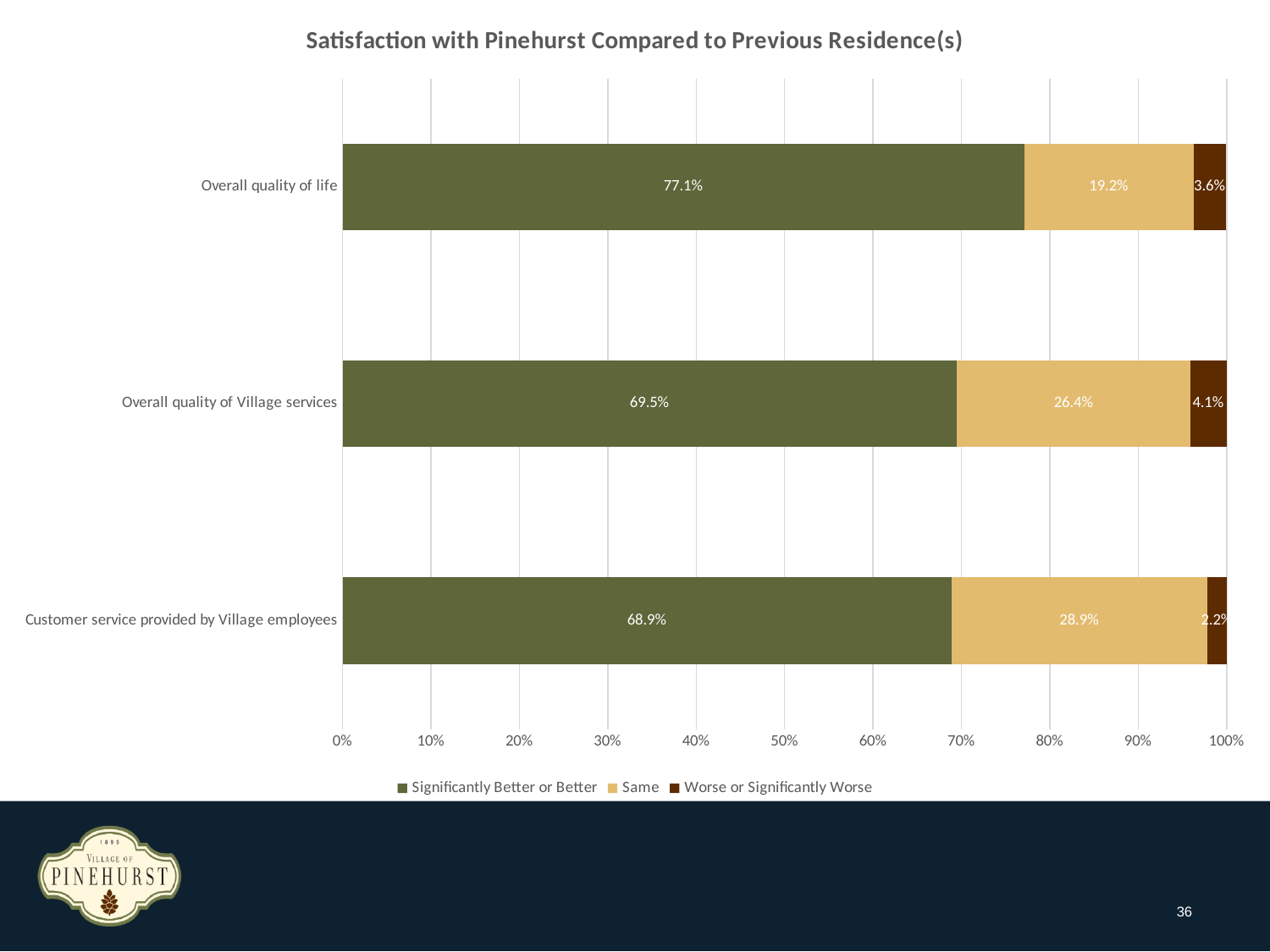
Which is larger: the 'Same' value for Customer service provided by Village employees or for Overall quality of Village services? Customer service provided by Village employees Which category has the lowest 'Same' percentage? Overall quality of life What percentage of respondents rated overall quality of life as Significantly Better or Better compared to previous residence(s)? 77.1% Which category has the highest 'Significantly Better or Better' percentage? Overall quality of life How many categories are shown on the chart? 3 What is the title of the chart? Satisfaction with Pinehurst Compared to Previous Residence(s) What is the 'Same' value for Overall quality of Village services? 26.4% What is the 'Worse or Significantly Worse' value for Customer service provided by Village employees? 2.2% What kind of chart is shown on the slide? Stacked bar chart How many series does the legend list? 3 Is the 'Significantly Better or Better' value for Customer service provided by Village employees greater or less than 70%? less What is the difference between the 'Significantly Better or Better' values for Overall quality of life and Overall quality of Village services? 7.6%